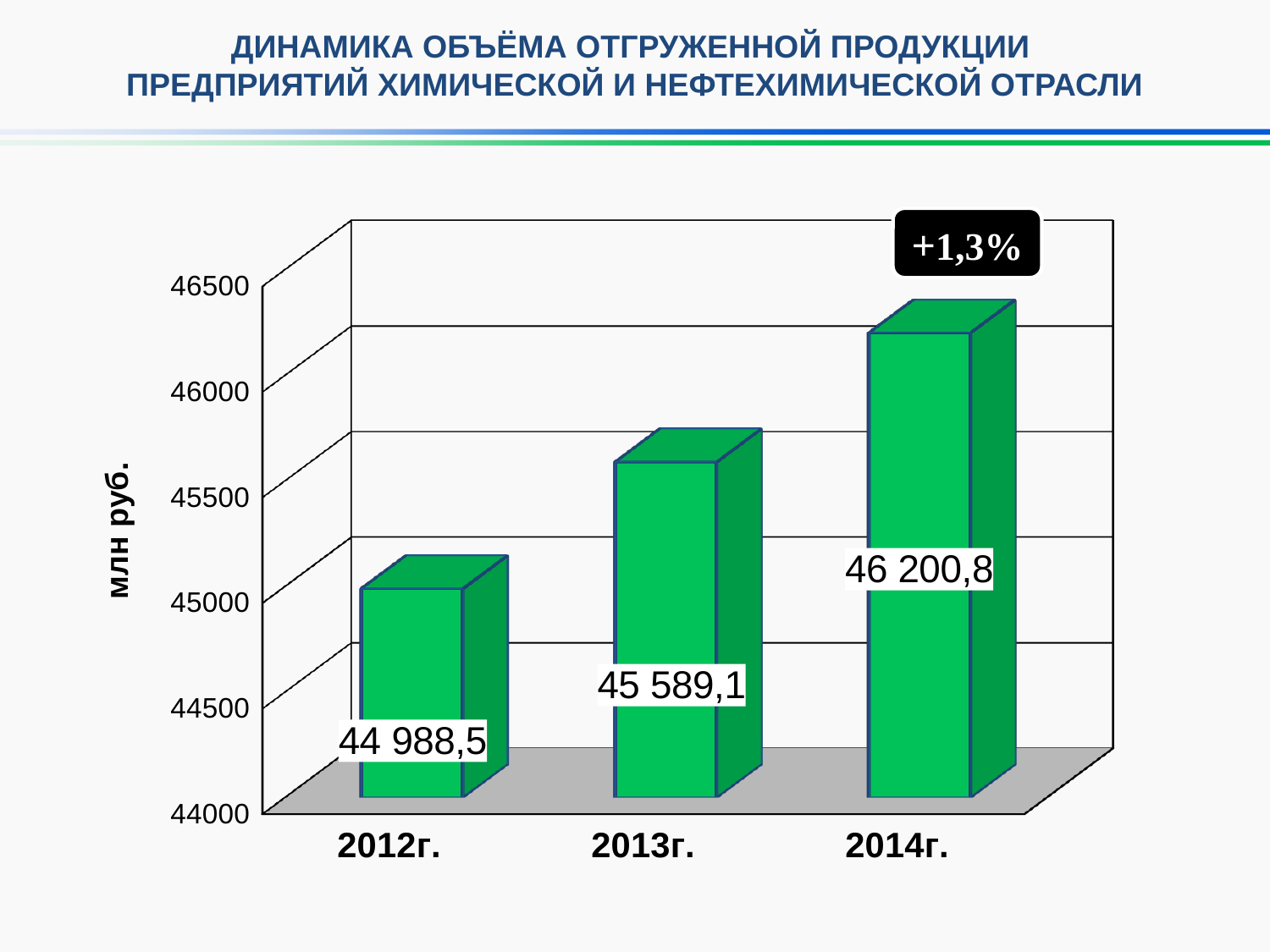
What is the value for 2014г.? 46 200,8 Which is larger, the value for 2012г. or the value for 2013г.? 2013г. What kind of chart is shown on the slide? bar chart Is the value for 2012г. greater or less than 45000? less How many years are shown on the chart? 3 Which year has the lowest value? 2012г. What is the value for 2012г.? 44 988,5 What is the value for 2013г.? 45 589,1 What is the difference between the values for 2014г. and 2013г.? 611,7 Do the values rise or fall from 2012г. to 2014г.? rise What is the difference between the values for 2013г. and 2012г.? 600,6 Which year has the highest value? 2014г.